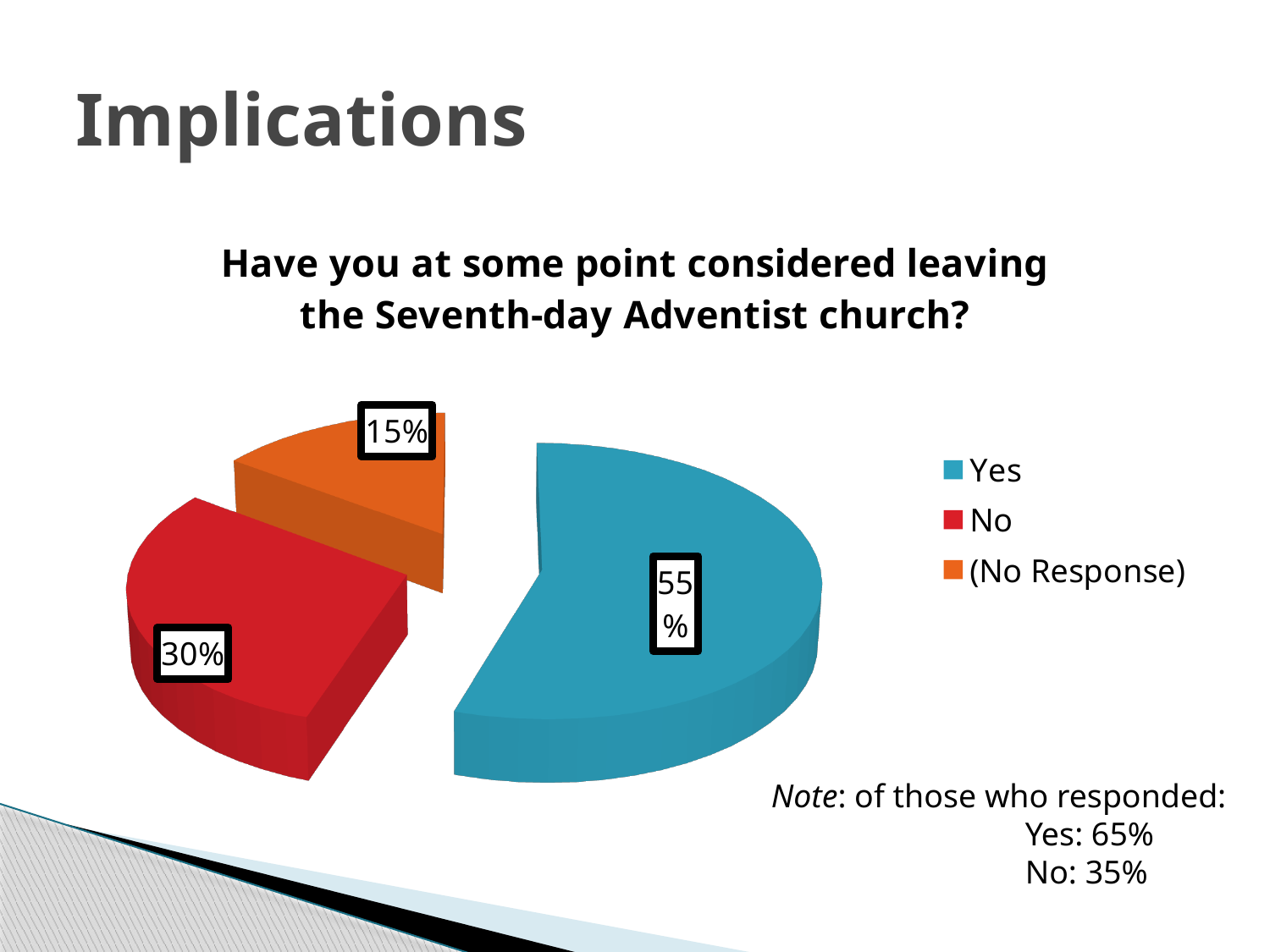
According to the note, what percentage of those who responded answered Yes? 65% What percentage is shown for (No Response)? 15% Which category has the largest slice of the pie? Yes What percentage of respondents answered Yes to having considered leaving the Seventh-day Adventist church? 55% Which category has the smallest slice of the pie? (No Response) Which is larger, the No slice or the (No Response) slice? No How many categories does the pie chart show? 3 What kind of chart is shown on the slide? Pie chart What colour is the Yes slice in the pie chart? Blue What percentage of respondents answered No? 30% What is the combined percentage of the Yes and No slices? 85% What is the difference in percentage points between the Yes and No slices? 25